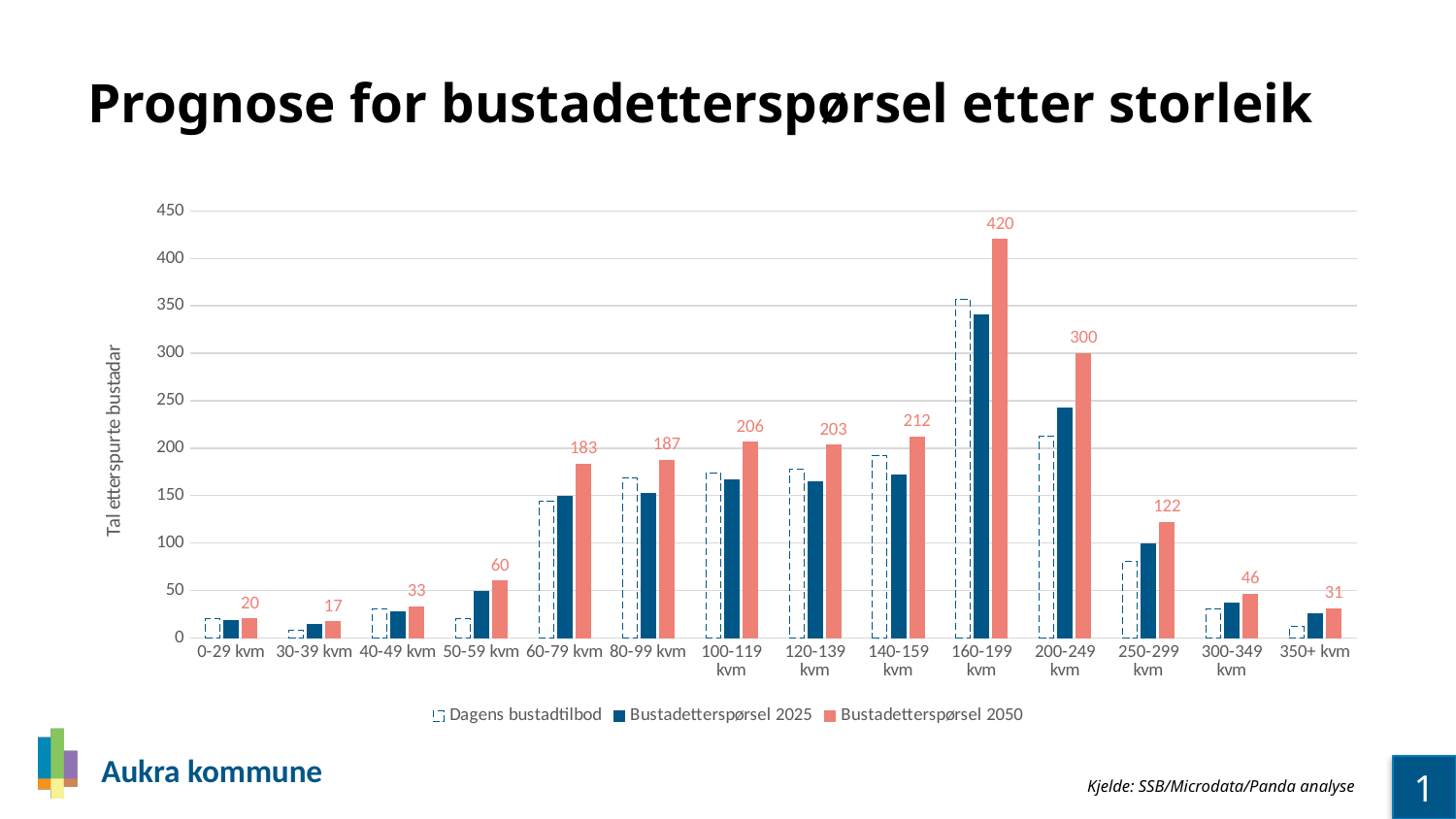
Is the Bustadetterspørsel 2025 value for 160-199 kvm greater or less than 300? greater Which size category has the lowest Bustadetterspørsel 2050 value? 30-39 kvm What kind of chart is shown on the slide? bar chart What is the difference between the Bustadetterspørsel 2050 values for 250-299 kvm and 300-349 kvm? 76 What is the difference between the Bustadetterspørsel 2050 values for 160-199 kvm and 200-249 kvm? 120 What is the Bustadetterspørsel 2050 value for 60-79 kvm? 183 Which size category has the highest Bustadetterspørsel 2050 value? 160-199 kvm How many series does the legend list? 3 Is the Bustadetterspørsel 2025 value for 200-249 kvm greater or less than 200? greater Which has the larger Bustadetterspørsel 2050 value, 140-159 kvm or 100-119 kvm? 140-159 kvm How many size categories are shown on the x axis? 14 What is the Bustadetterspørsel 2050 value for 160-199 kvm? 420